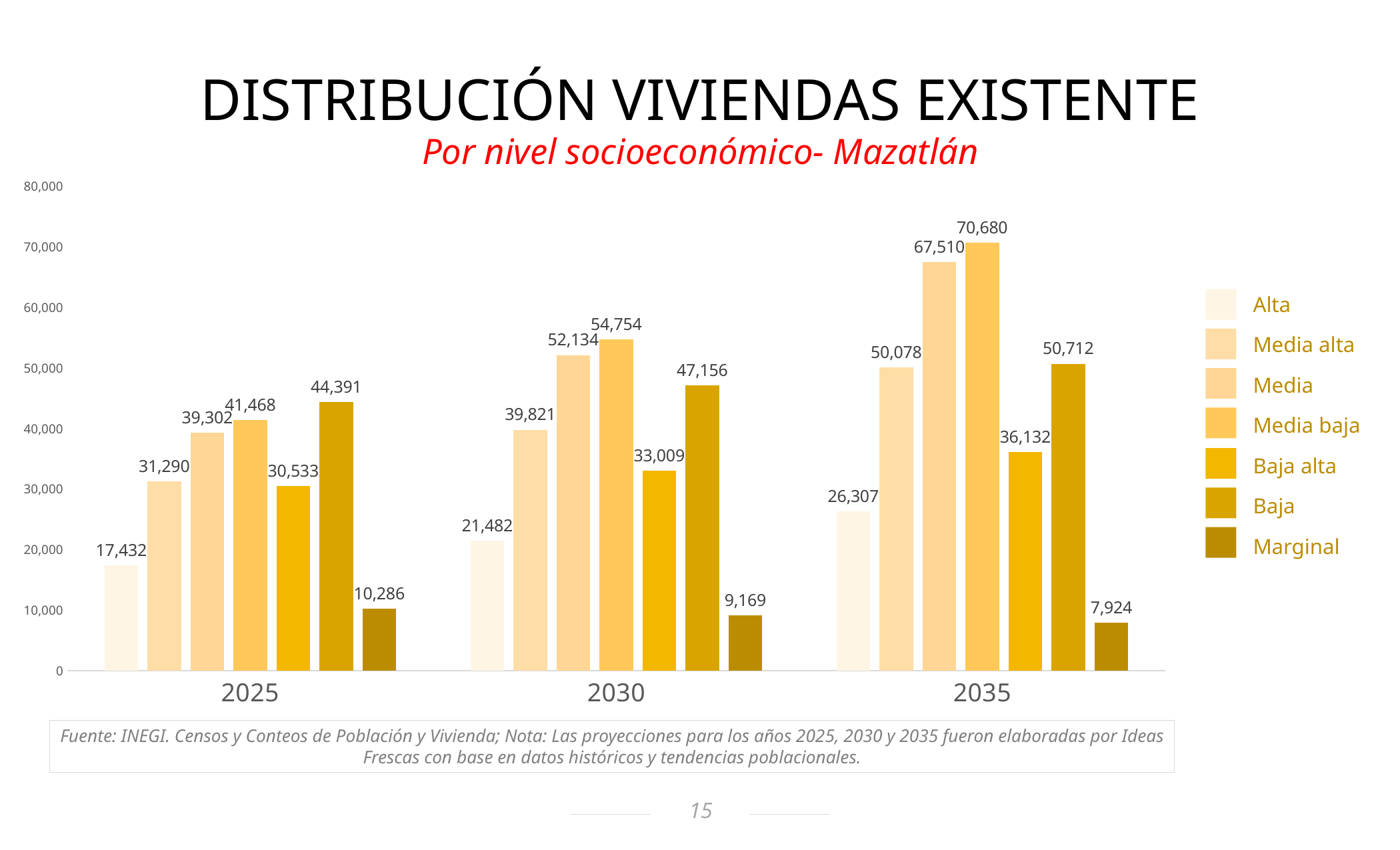
Does the value for Marginal rise or fall from 2025 to 2035? Fall How many year categories are shown on the x axis? 3 Is the value for Media in 2035 greater or less than 60,000? greater Which series has the highest value in 2025? Baja Which series has the lowest value in 2030? Marginal What kind of chart is shown on the slide? Bar chart What is the difference between the Media baja and Media values in 2030? 2,620 What is the value for Baja alta in 2030? 33,009 What is the value for Media baja in 2035? 70,680 Which is larger in 2035: Baja or Media alta? Baja What is the value for Alta in 2025? 17,432 How many series does the legend list? 7